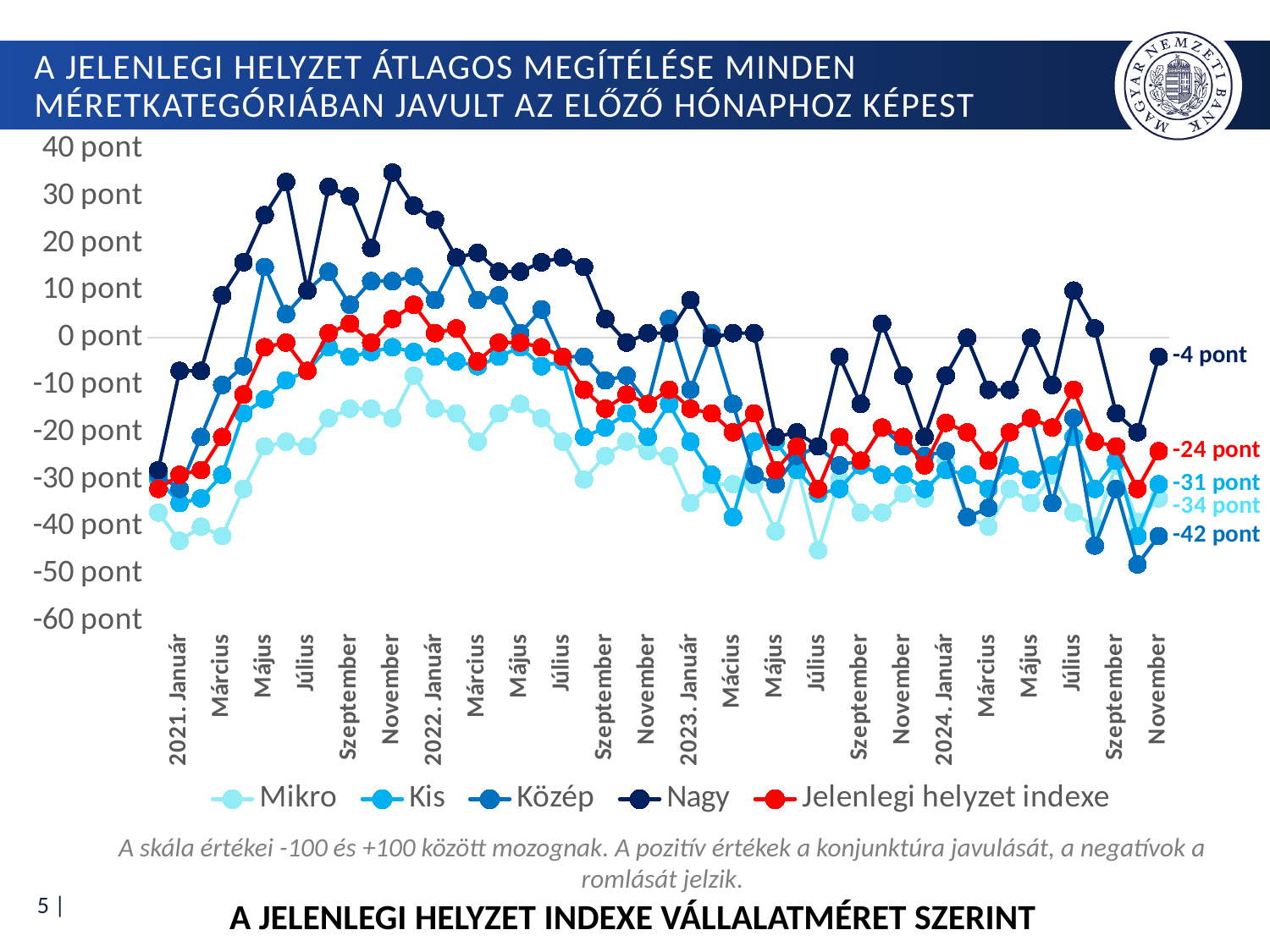
What is the value of the Jelenlegi helyzet indexe series at the last point (November 2024)? -24 pont Which series has the lowest value at the last point (November 2024)? Közép At the last point (November 2024), which is larger: the Nagy value or the Mikro value? Nagy Is the value of the Nagy series in November 2021 greater or less than 30 pont? greater What is the value of the Közép series at the last point (November 2024)? -42 pont What is the title printed below the chart? A JELENLEGI HELYZET INDEXE VÁLLALATMÉRET SZERINT Does the Nagy series rise or fall between 2021. Január and November 2021? rise What is the value of the Nagy series at the last point (November 2024)? -4 pont What kind of chart is shown on the slide? line chart How many series does the legend list? 5 Which series has the highest value at the last point (November 2024)? Nagy What is the difference between the Nagy value and the Jelenlegi helyzet indexe value at the last point (November 2024)? 20 pont